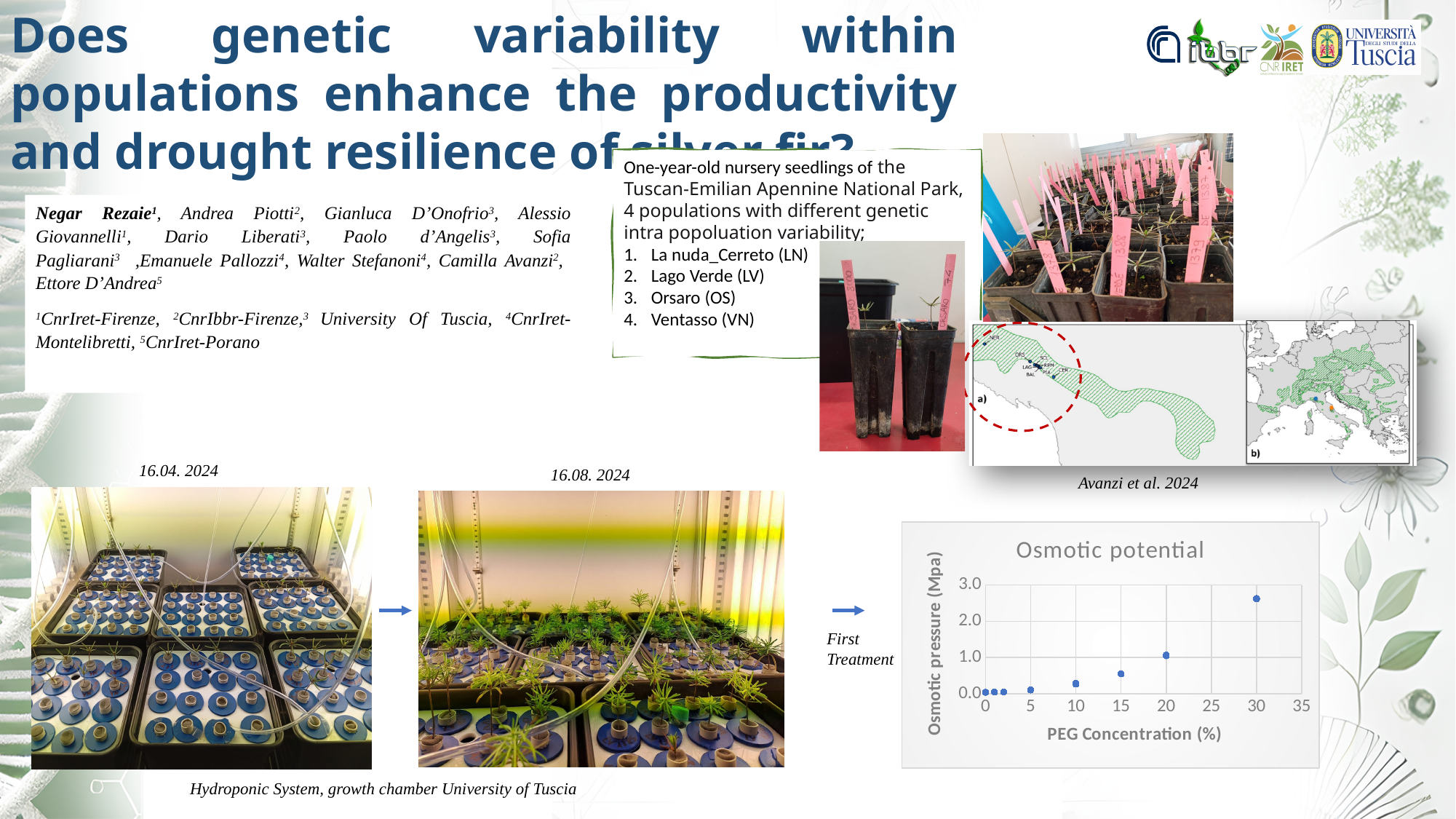
In the "Osmotic potential" chart, is the osmotic pressure at 10% PEG greater or less than 1.0? less In the "Osmotic potential" chart, is the osmotic pressure at 15% PEG greater or less than 1.0? less In the "Osmotic potential" chart, which has the higher osmotic pressure: 30% PEG or 20% PEG? 30% PEG In the "Osmotic potential" chart, at which PEG concentration is the osmotic pressure highest? 30 In the "Osmotic potential" chart, is the osmotic pressure at 20% PEG greater or less than 2.0? less In the "Osmotic potential" chart, does osmotic pressure rise or fall as PEG concentration increases? rise In the "Osmotic potential" chart, which has the higher osmotic pressure: 15% PEG or 10% PEG? 15% PEG What is the title of the chart on the slide? Osmotic potential What kind of chart is the "Osmotic potential" chart? scatter plot What is the label of the x axis of the "Osmotic potential" chart? PEG Concentration (%)